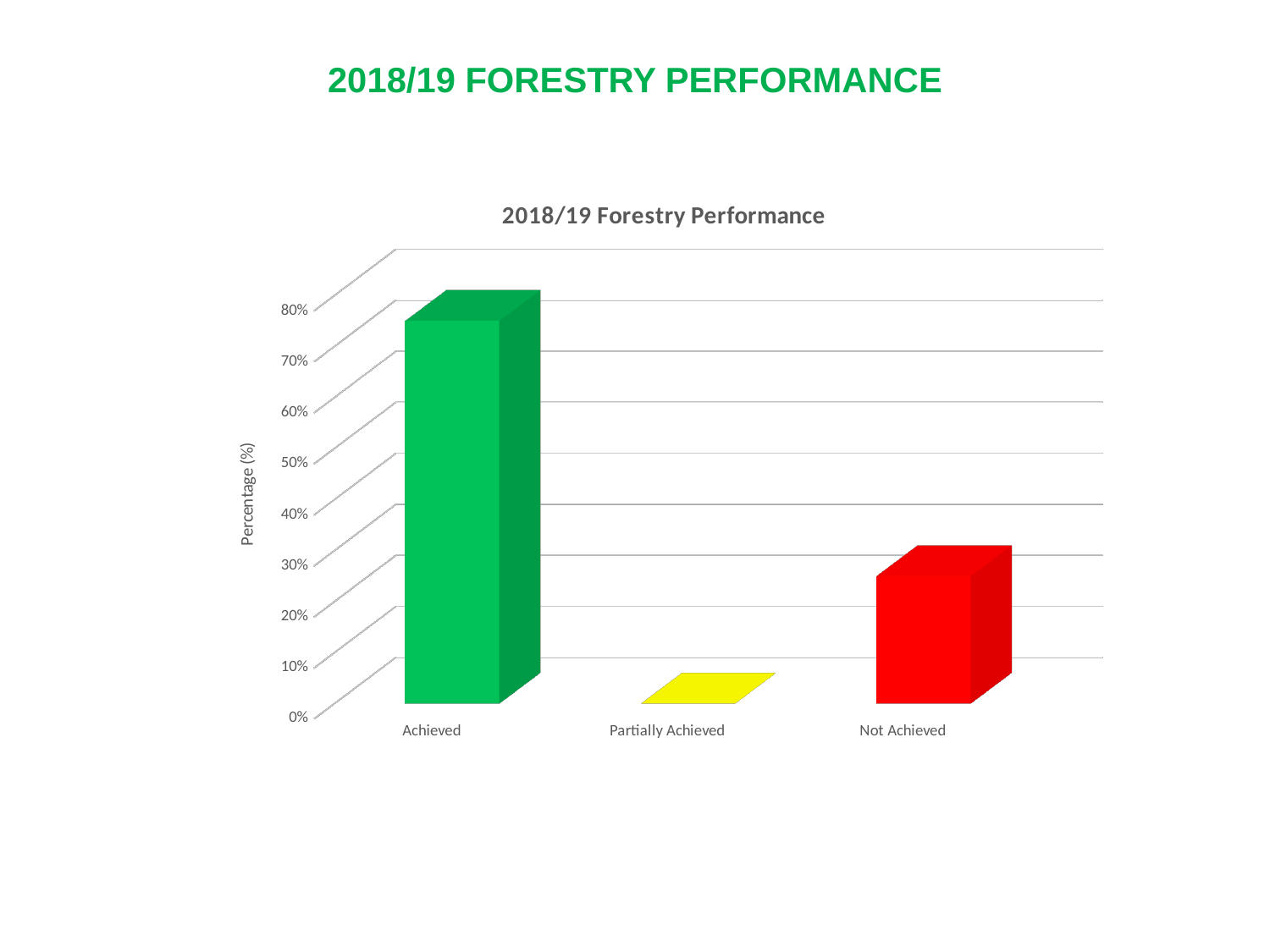
Is the value for Achieved greater or less than 60%? greater Is the value for Achieved greater or less than 70%? greater What is the title of the chart? 2018/19 Forestry Performance How many categories are shown on the x axis of the chart? 3 Is the value for Not Achieved greater or less than 30%? less What is the label on the vertical axis of the chart? Percentage (%) What is the value for Partially Achieved? 0% Which category has the highest value in the chart? Achieved Which category has the lowest value in the chart? Partially Achieved Which is larger, the value for Achieved or the value for Not Achieved? Achieved What kind of chart is shown on the slide? Bar chart